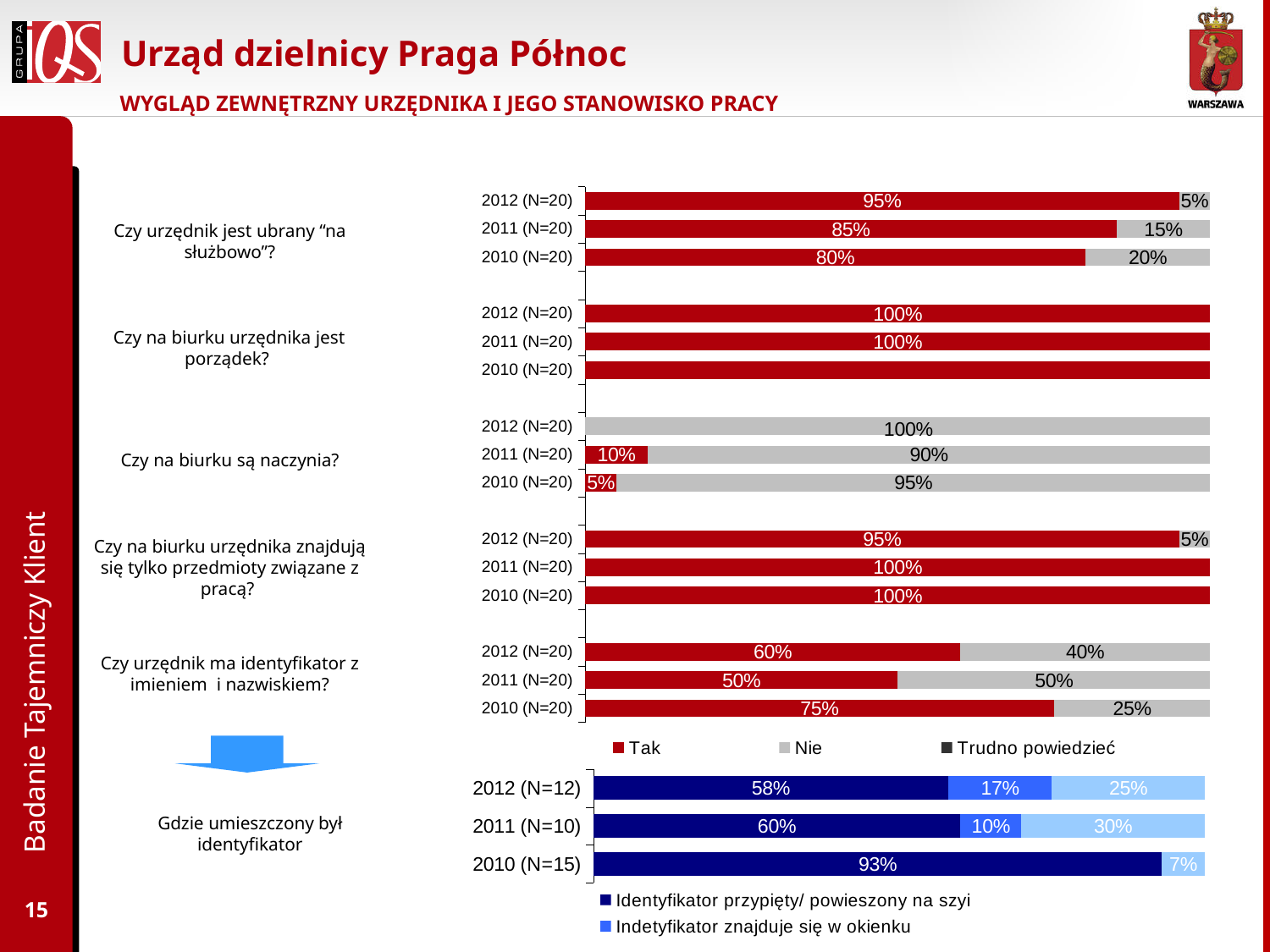
In the upper chart, what percentage answered "Tak" to "Czy na biurku są naczynia?" in 2011 (N=20)? 10% In the upper chart, what percentage answered "Tak" to "Czy urzędnik jest ubrany 'na służbowo'?" in 2012 (N=20)? 95% In the upper chart, what percentage answered "Nie" to "Czy urzędnik jest ubrany 'na służbowo'?" in 2010 (N=20)? 20% In the upper chart, for "Czy urzędnik ma identyfikator z imieniem i nazwiskiem?", which year has the lowest "Tak" share? 2011 (N=20) In the upper chart, for "Czy urzędnik ma identyfikator z imieniem i nazwiskiem?", is the "Tak" share larger in 2012 or in 2010? 2010 What kind of chart is the upper chart? Stacked bar chart In the upper chart, for "Czy urzędnik jest ubrany 'na służbowo'?", which year has the highest "Tak" share? 2012 (N=20) How many series does the legend of the upper chart list? 3 How many year bars does the lower chart ("Gdzie umieszczony był identyfikator") show? 3 In the upper chart, what is the difference between the "Tak" shares for "Czy urzędnik jest ubrany 'na służbowo'?" in 2012 and 2010? 15% In the lower chart ("Gdzie umieszczony był identyfikator"), what percentage for 2010 (N=15) corresponds to "Identyfikator przypięty/ powieszony na szyi"? 93% In the lower chart ("Gdzie umieszczony był identyfikator"), what percentage for 2012 (N=12) corresponds to "Indetyfikator znajduje się w okienku"? 17%